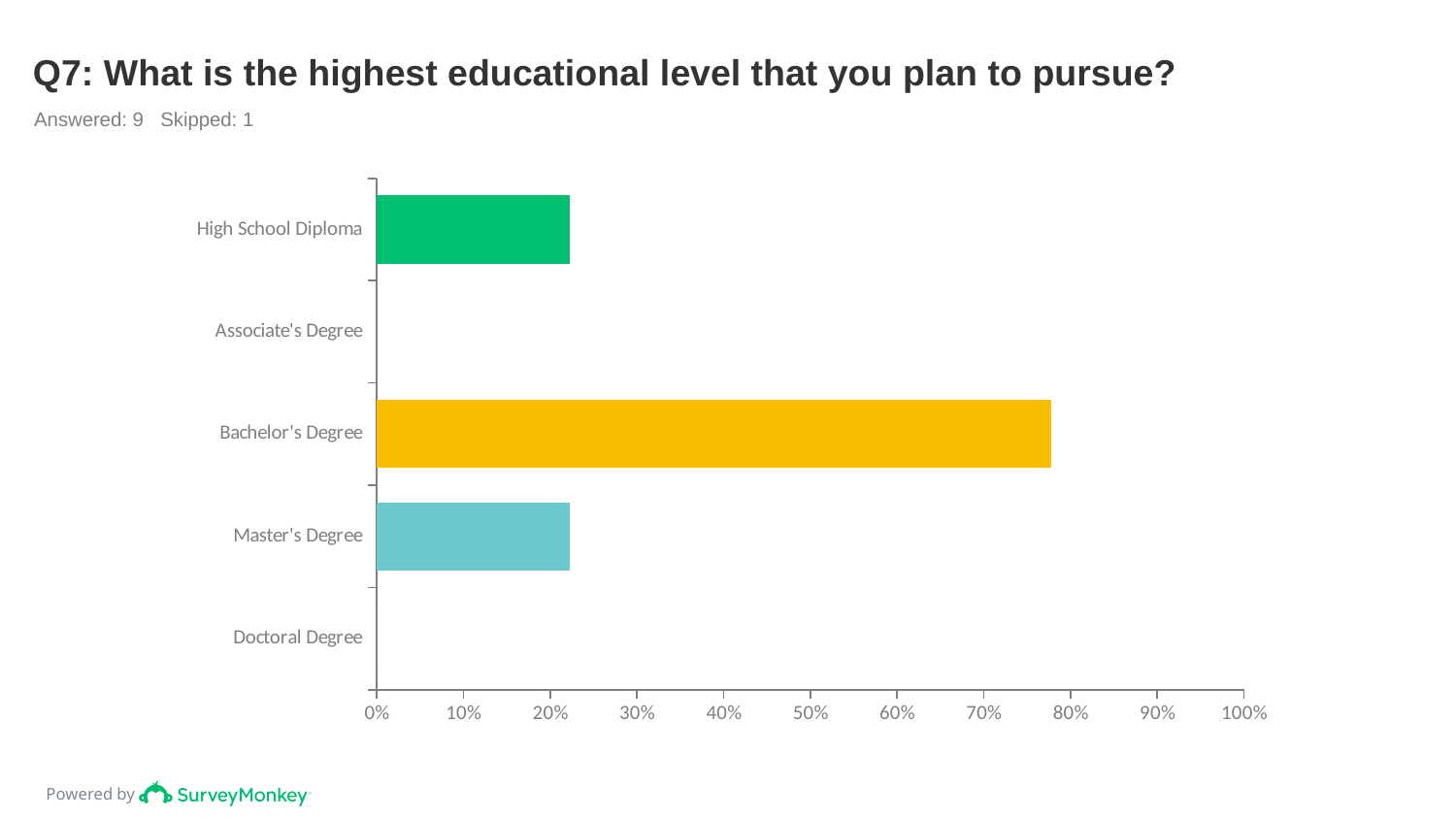
What is the title of the chart? Q7: What is the highest educational level that you plan to pursue? Is the value for Bachelor's Degree greater or less than 70%? greater Which educational level has the highest value? Bachelor's Degree What kind of chart is shown on the slide? bar chart Which is larger, the value for Bachelor's Degree or the value for High School Diploma? Bachelor's Degree Is the value for Master's Degree greater or less than 30%? less Is the value for Bachelor's Degree greater or less than 50%? greater What is the value for Associate's Degree? 0% Which is larger, the value for Master's Degree or the value for Doctoral Degree? Master's Degree How many respondents answered the question according to the slide? 9 How many educational level categories are shown on the chart? 5